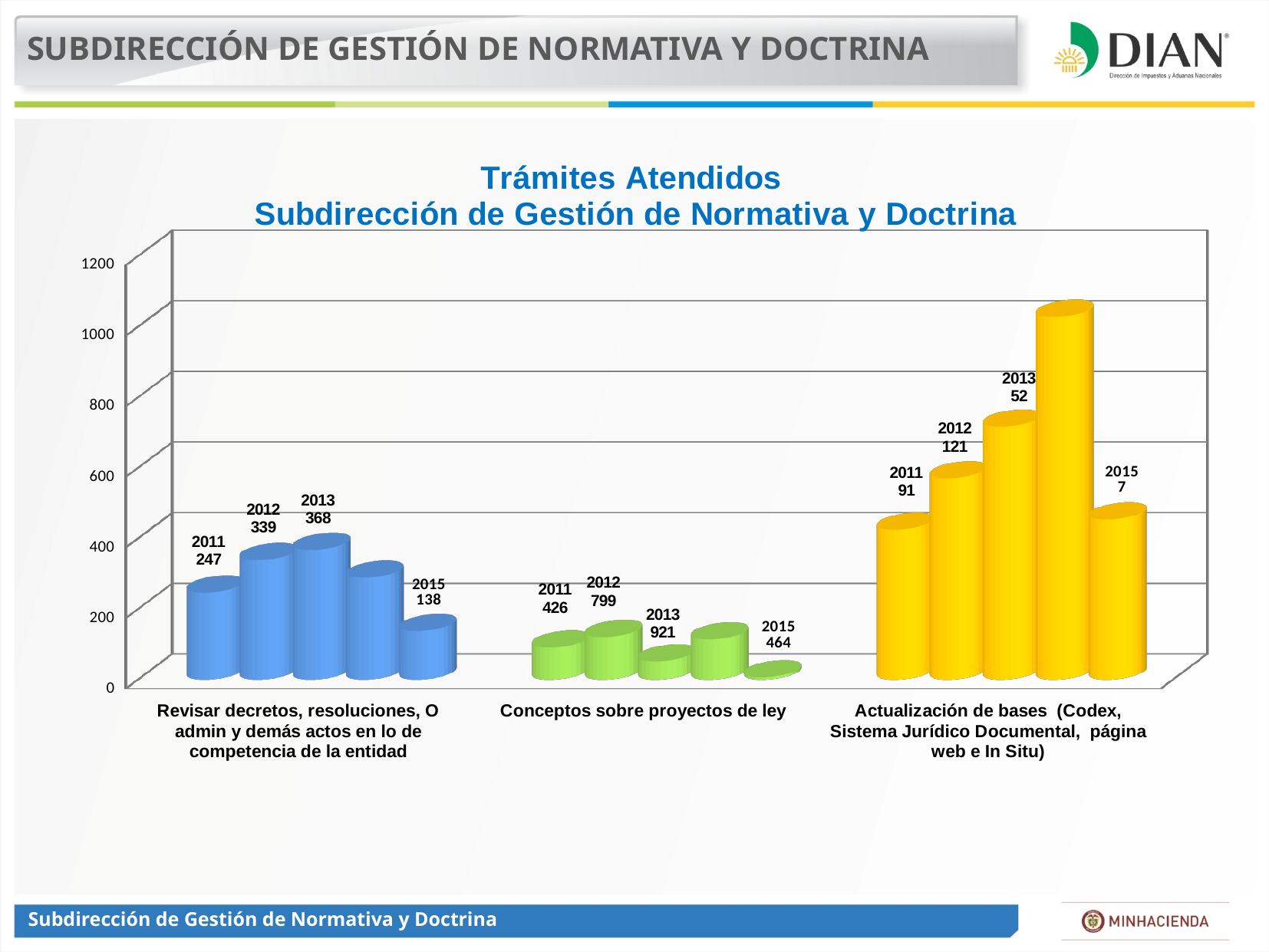
How many categories are shown on the x axis of the chart? 3 What is the value labelled for 2011 in the 'Revisar decretos, resoluciones, O admin y demás actos en lo de competencia de la entidad' category? 247 What is the value labelled for 2015 in the 'Revisar decretos, resoluciones, O admin y demás actos' category? 138 What is the value labelled for 2012 in the 'Actualización de bases' category? 121 What is the value labelled for 2015 in the 'Actualización de bases (Codex, Sistema Jurídico Documental, página web e In Situ)' category? 7 Which has the larger labelled value for 2012: 'Conceptos sobre proyectos de ley' or 'Revisar decretos, resoluciones, O admin y demás actos'? Conceptos sobre proyectos de ley What is the difference between the 2013 and 2012 labelled values in the 'Revisar decretos, resoluciones, O admin y demás actos' category? 29 How many bars are shown in each category of the chart? 5 What is the value labelled for 2013 in the 'Conceptos sobre proyectos de ley' category? 921 What kind of chart is shown on the slide? Bar chart What is the difference between the 2012 and 2011 labelled values in the 'Conceptos sobre proyectos de ley' category? 373 What is the title of the chart? Trámites Atendidos Subdirección de Gestión de Normativa y Doctrina